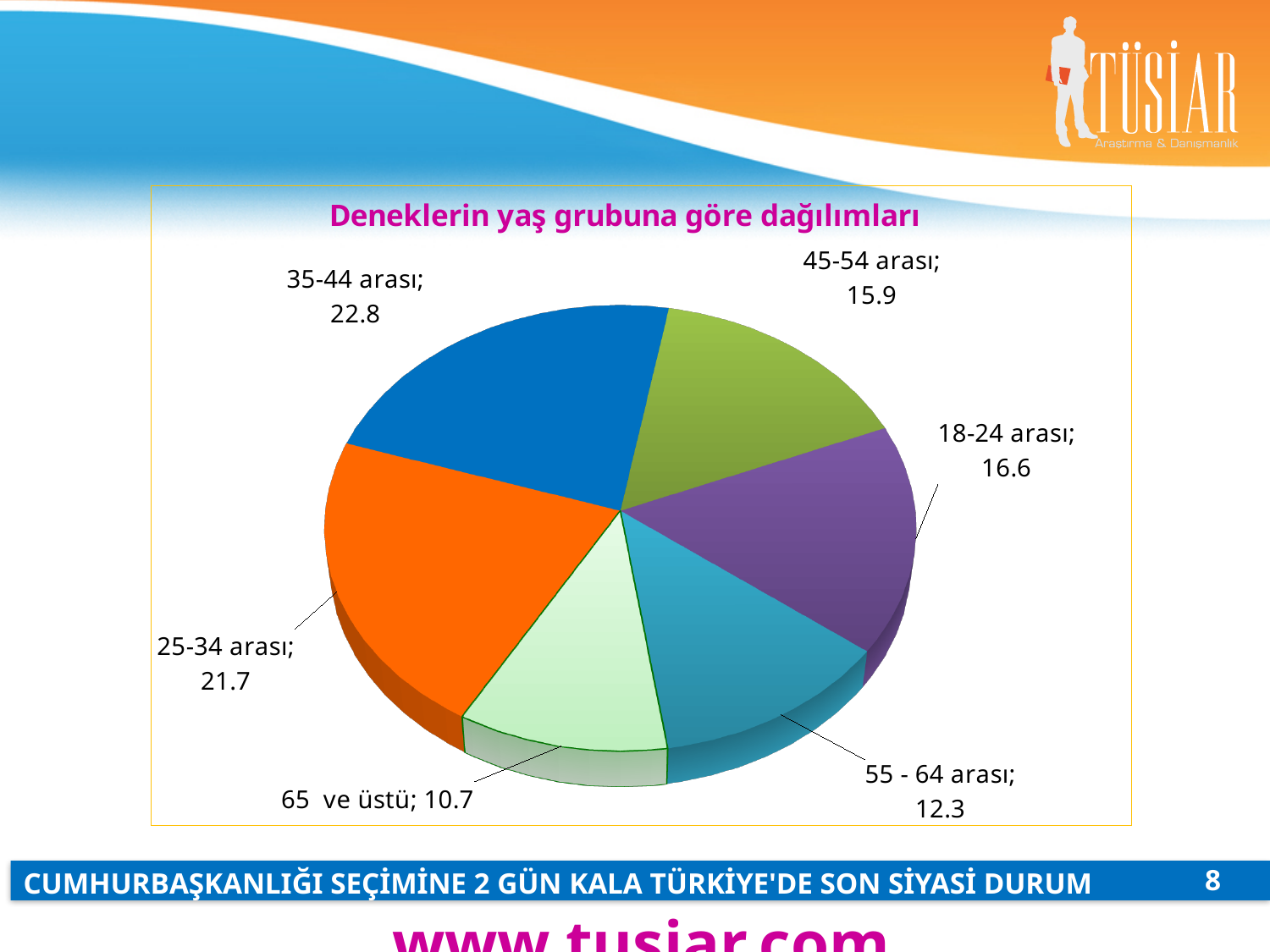
What is the difference between the values for 45-54 arası and 55 - 64 arası? 3.6 Which age group has the largest slice? 35-44 arası Which is larger, the value for 18-24 arası or the value for 45-54 arası? 18-24 arası What is the difference between the values for 35-44 arası and 25-34 arası? 1.1 What is the title of the chart? Deneklerin yaş grubuna göre dağılımları What is the value for the 18-24 arası slice? 16.6 What is the value for the 35-44 arası slice? 22.8 How many age groups are shown in the pie chart? 6 Which age group has the smallest slice? 65 ve üstü What is the value for the 55 - 64 arası slice? 12.3 What kind of chart is shown on the slide? pie chart What is the value for the 65 ve üstü slice? 10.7